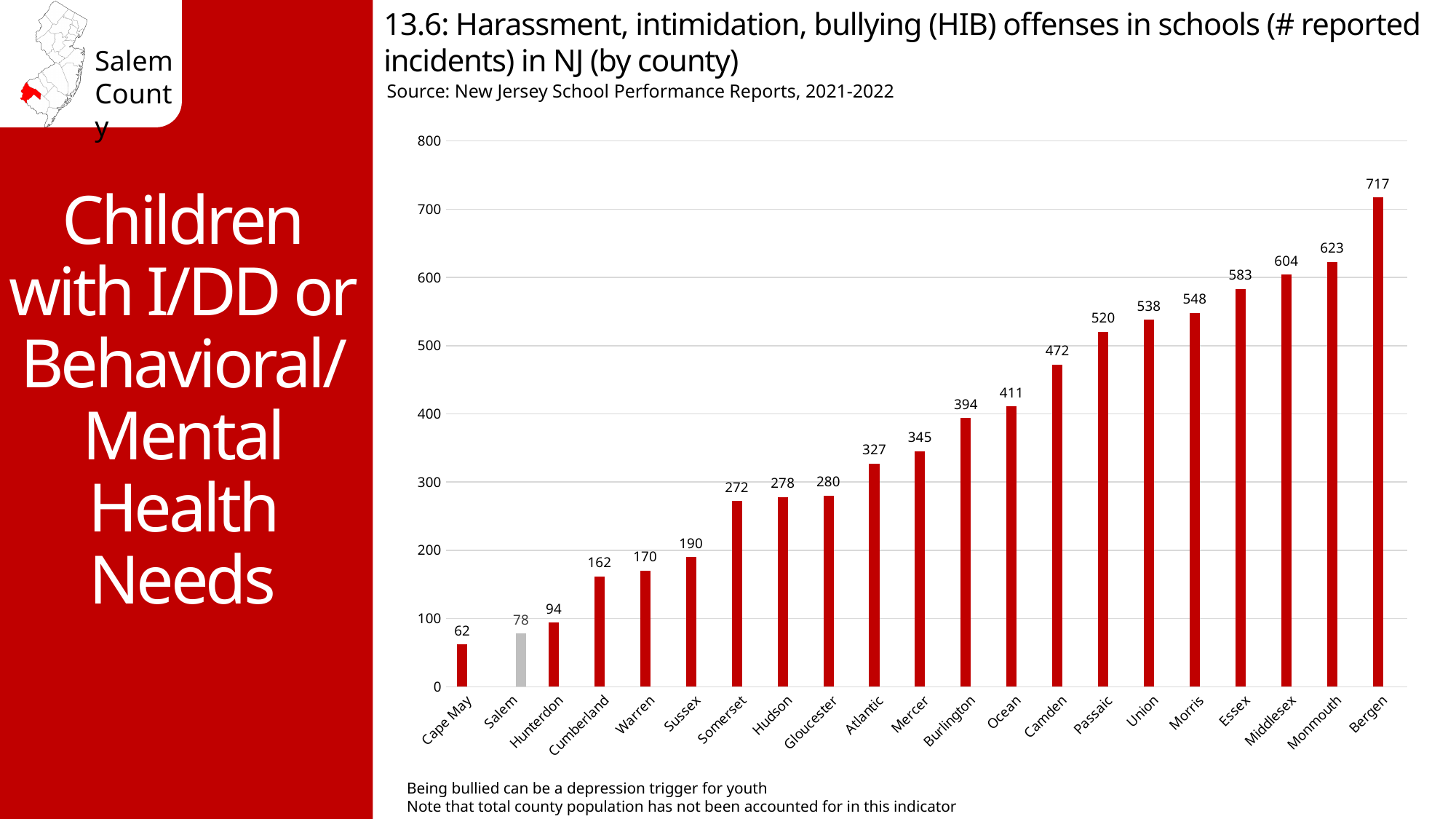
What is the number of reported HIB incidents for Gloucester county? 280 How many counties are shown on the chart? 21 What is the number of reported HIB incidents for Salem county? 78 What is the difference in reported HIB incidents between Salem and Cumberland? 84 Is the value for Passaic greater or less than 500? greater Which county has the highest number of reported HIB incidents? Bergen What is the difference in reported HIB incidents between Bergen and Cape May? 655 Which county has the lowest number of reported HIB incidents? Cape May Which county's bar is shown in grey rather than red? Salem What is the number of reported HIB incidents for Bergen county? 717 What kind of chart is shown on the slide? Bar chart Which county has more reported HIB incidents, Camden or Ocean? Camden